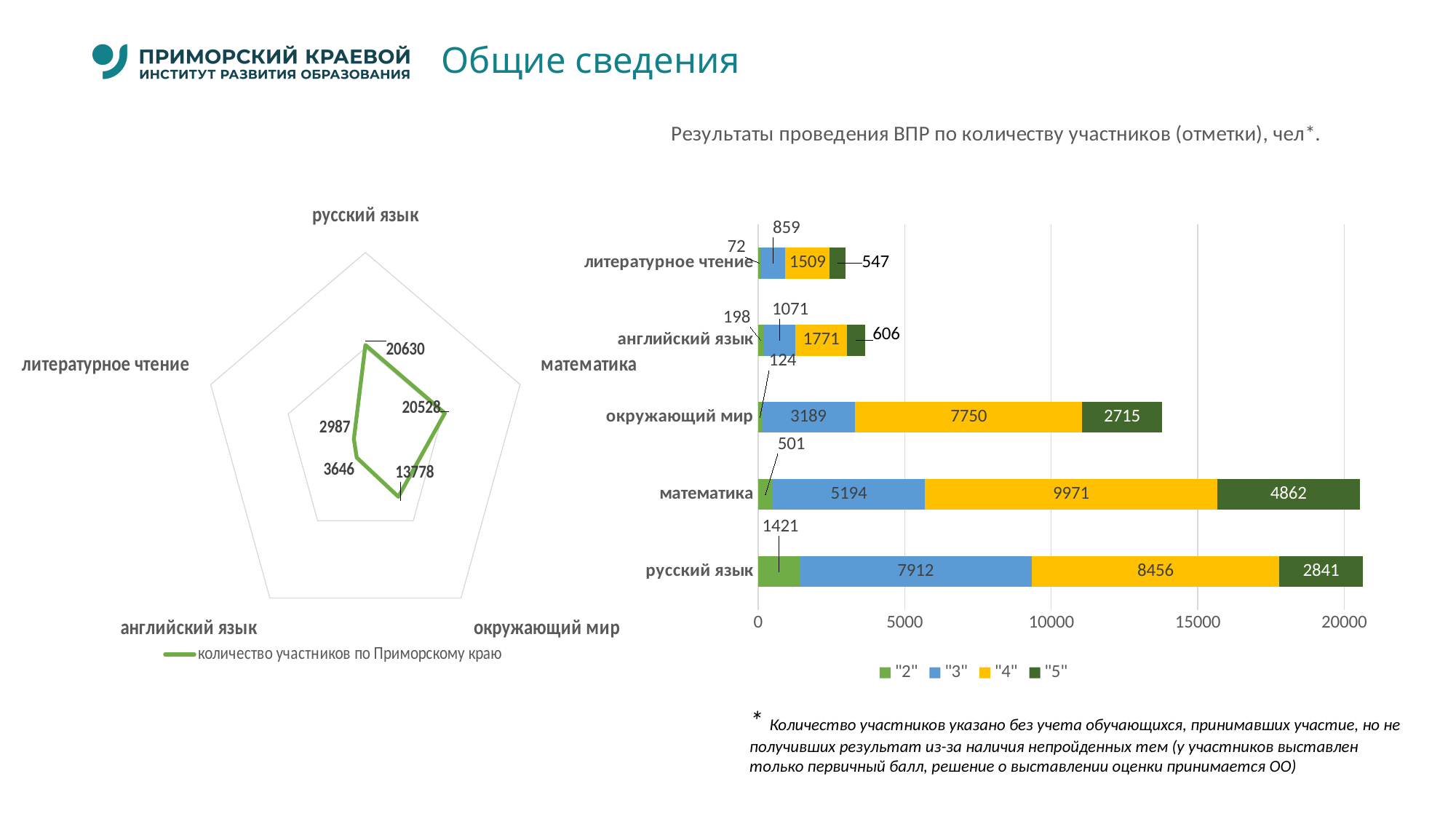
In the stacked bar chart on the right, which is larger: the "3" value for русский язык or the "3" value for математика? русский язык In the stacked bar chart on the right, what is the value of the "4" series for математика? 9971 In the stacked bar chart on the right, how many series does the legend list? 4 In the stacked bar chart on the right, which subject has the highest value for the "5" series? математика In the radar chart on the left, which subject has the lowest number of participants? литературное чтение In the radar chart on the left, how many subjects are plotted? 5 In the radar chart on the left, what is the number of participants for русский язык? 20630 In the stacked bar chart on the right, what is the total of the stacked bar for окружающий мир? 13778 In the stacked bar chart on the right, what is the difference between the "4" and "5" values for английский язык? 1165 What type of chart is shown on the right side of the slide? stacked bar chart In the radar chart on the left, what is the difference between the values for русский язык and математика? 102 In the stacked bar chart on the right, what is the value of the "2" series for русский язык? 1421